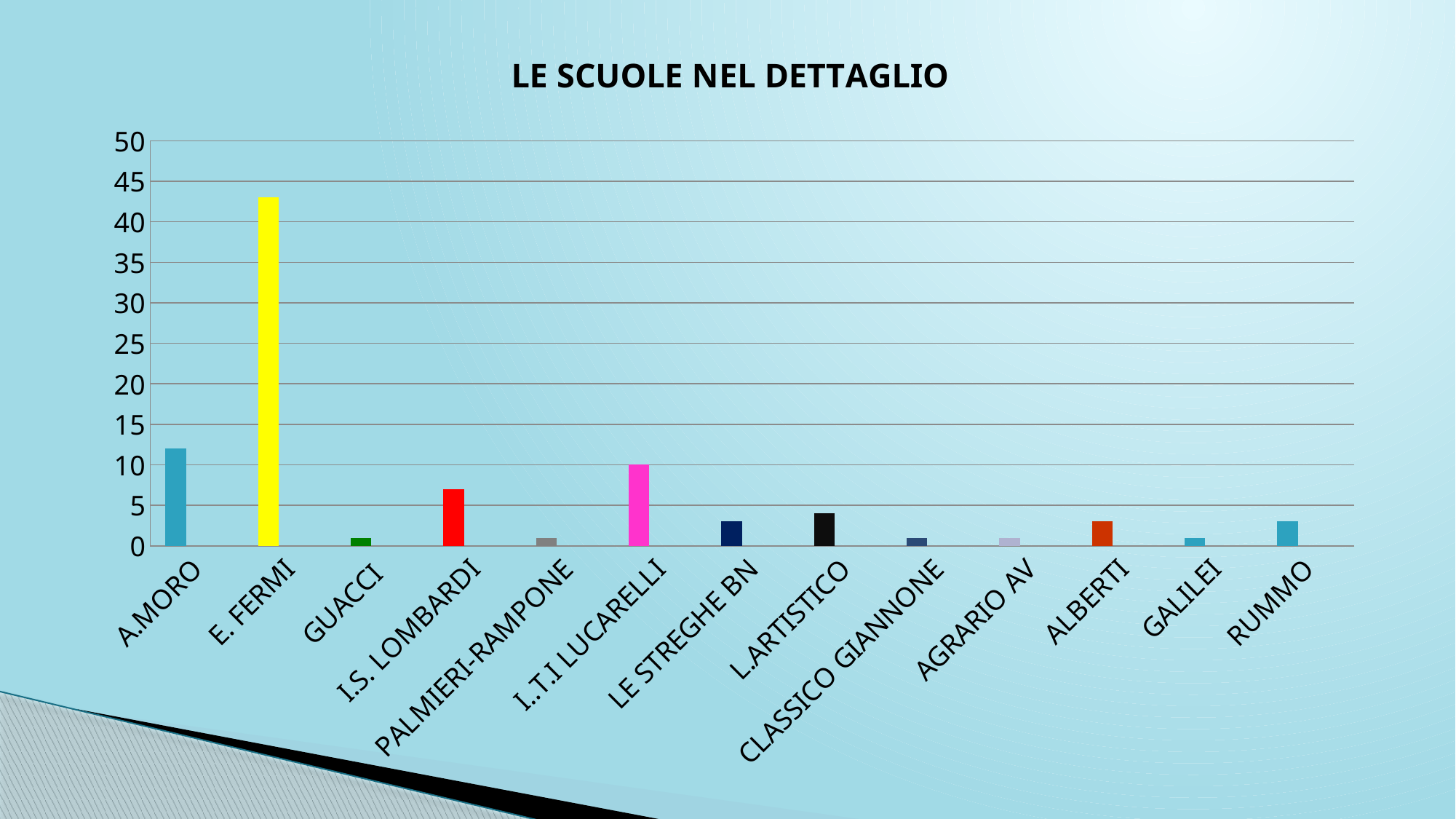
Is the value for A.MORO greater or less than 10? greater Which is larger, the value for A.MORO or the value for I.S. LOMBARDI? A.MORO Is the value for I.S. LOMBARDI greater or less than 5? greater What is the value for I..T.I LUCARELLI? 10 What is the title of the chart? LE SCUOLE NEL DETTAGLIO How many schools (categories) are shown on the x axis? 13 Which school has the highest bar? E. FERMI What colour is the bar for E. FERMI? yellow Is the value for E. FERMI greater or less than 40? greater Which is larger, the value for L.ARTISTICO or the value for GUACCI? L.ARTISTICO What kind of chart is shown on the slide? bar chart